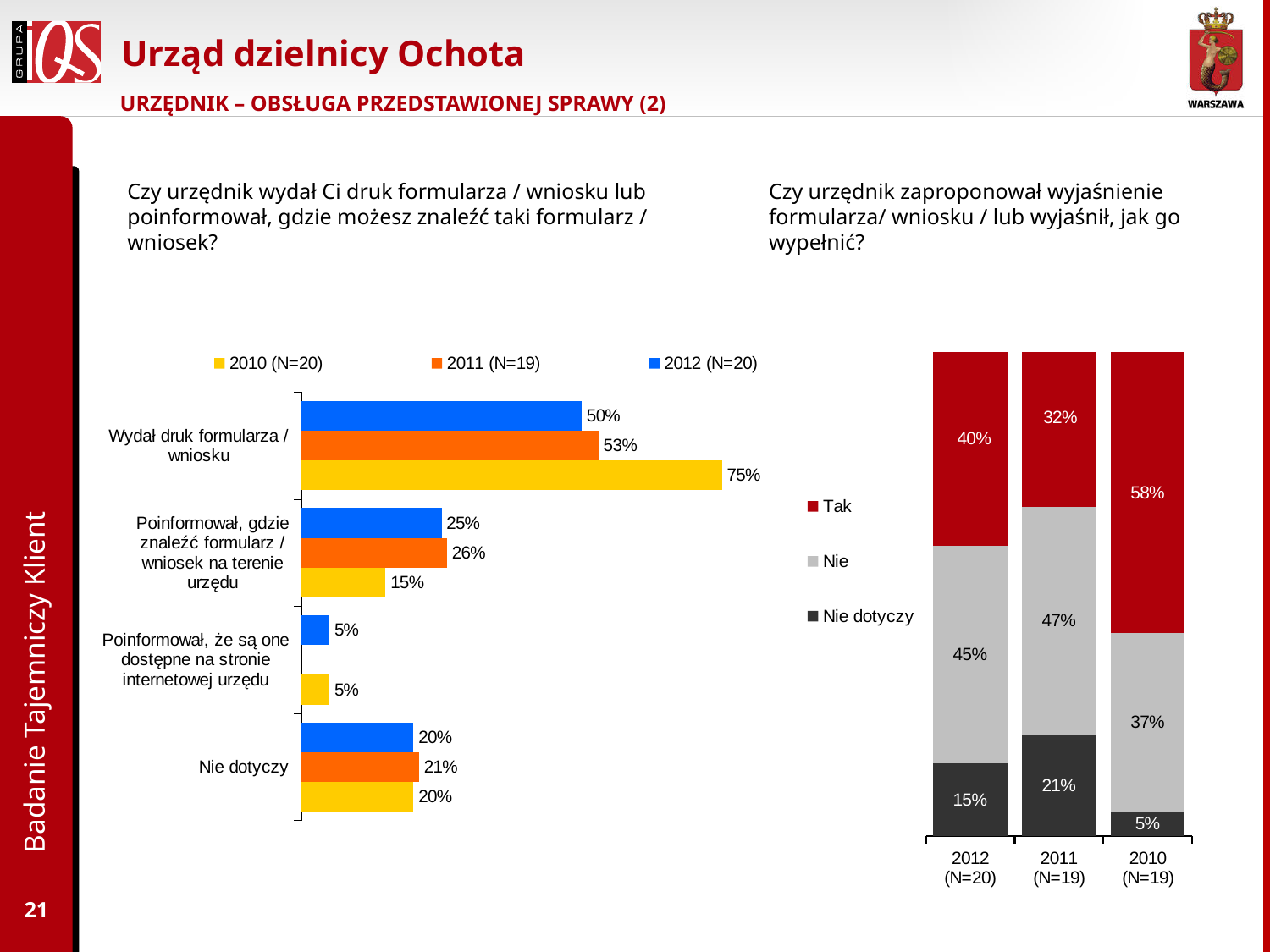
In the left chart, what is the 2012 (N=20) value for 'Nie dotyczy'? 20% In the left chart, how many categories are shown on the vertical axis? 4 In the left chart, what is the difference between the 2010 and 2012 values for 'Wydał druk formularza / wniosku'? 25 percentage points In the right chart, what is the 'Tak' share for 2011 (N=19)? 32% In the right chart, which year has the highest 'Tak' share? 2010 (N=19) In the right chart, what is the 'Nie dotyczy' share for 2010 (N=19)? 5% What kind of chart is the chart on the right side of the slide? Stacked bar chart In the left chart, which year has the highest value for 'Wydał druk formularza / wniosku'? 2010 (N=20) In the left chart, what is the 2011 (N=19) value for 'Poinformował, gdzie znaleźć formularz / wniosek na terenie urzędu'? 26% In the left chart, what is the 2010 (N=20) value for 'Wydał druk formularza / wniosku'? 75% In the left chart, how many series does the legend list? 3 In the right chart, is the 'Nie' share for 2012 (N=20) larger or smaller than the 'Tak' share for 2012 (N=20)? Larger